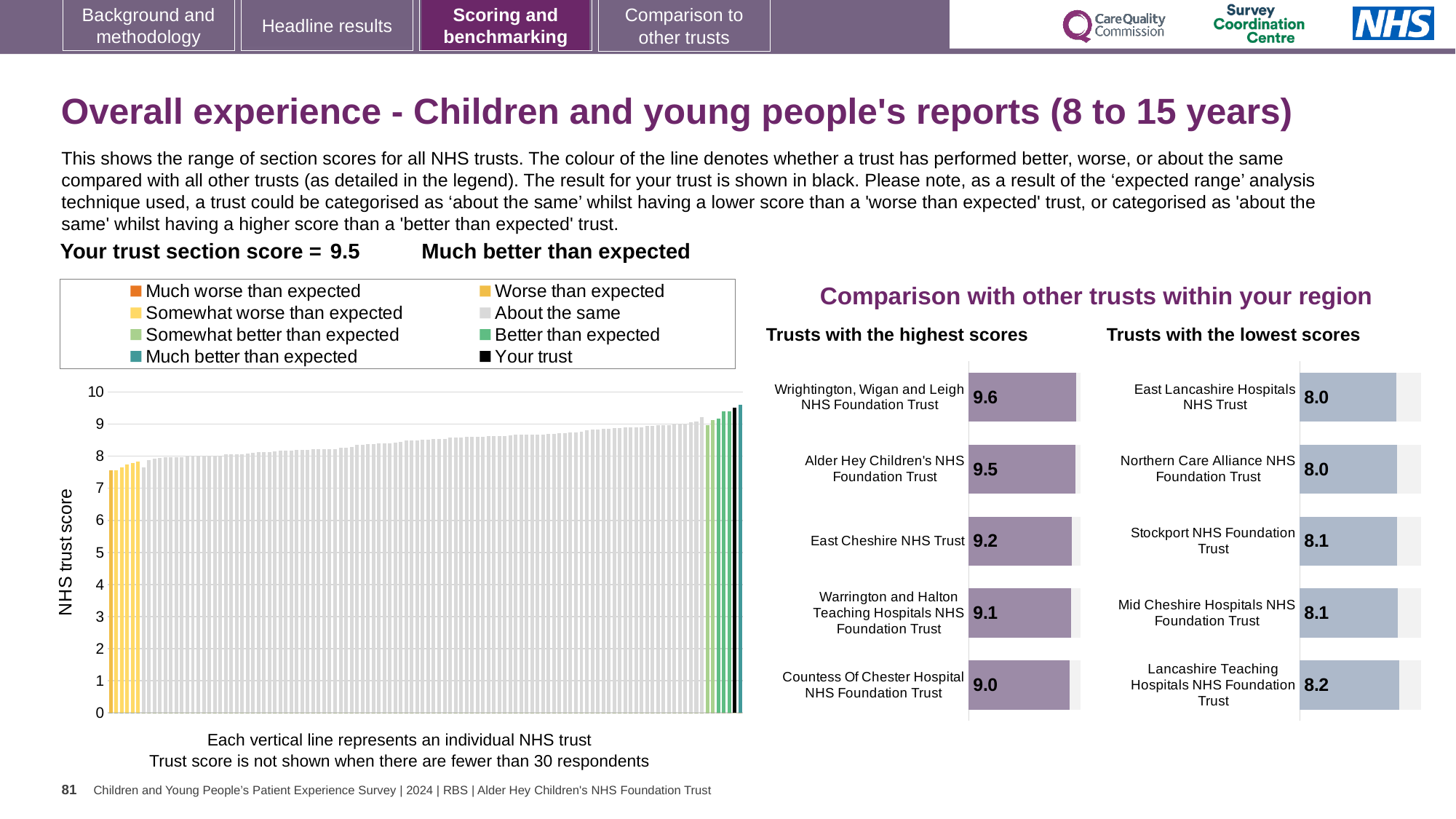
In the 'Trusts with the lowest scores' chart, which trust has the highest score? Lancashire Teaching Hospitals NHS Foundation Trust What kind of chart is the main chart showing NHS trust scores on the left of the slide? Bar chart In the 'Trusts with the highest scores' chart, what is the score for Wrightington, Wigan and Leigh NHS Foundation Trust? 9.6 How many trusts are shown in the 'Trusts with the highest scores' chart? 5 In the 'Trusts with the lowest scores' chart, which has the larger score: Stockport NHS Foundation Trust or Lancashire Teaching Hospitals NHS Foundation Trust? Lancashire Teaching Hospitals NHS Foundation Trust How many entries does the legend of the main NHS trust score chart list? 8 In the 'Trusts with the lowest scores' chart, what is the score for Lancashire Teaching Hospitals NHS Foundation Trust? 8.2 In the 'Trusts with the highest scores' chart, which trust has the highest score? Wrightington, Wigan and Leigh NHS Foundation Trust In the 'Trusts with the highest scores' chart, what is the score for East Cheshire NHS Trust? 9.2 In the 'Trusts with the highest scores' chart, what is the difference between the scores of Wrightington, Wigan and Leigh NHS Foundation Trust and Countess Of Chester Hospital NHS Foundation Trust? 0.6 In the 'Trusts with the highest scores' chart, which trust has the lowest score? Countess Of Chester Hospital NHS Foundation Trust In the main NHS trust score chart on the left, is the value for the lowest-scoring trust greater or less than 7? greater